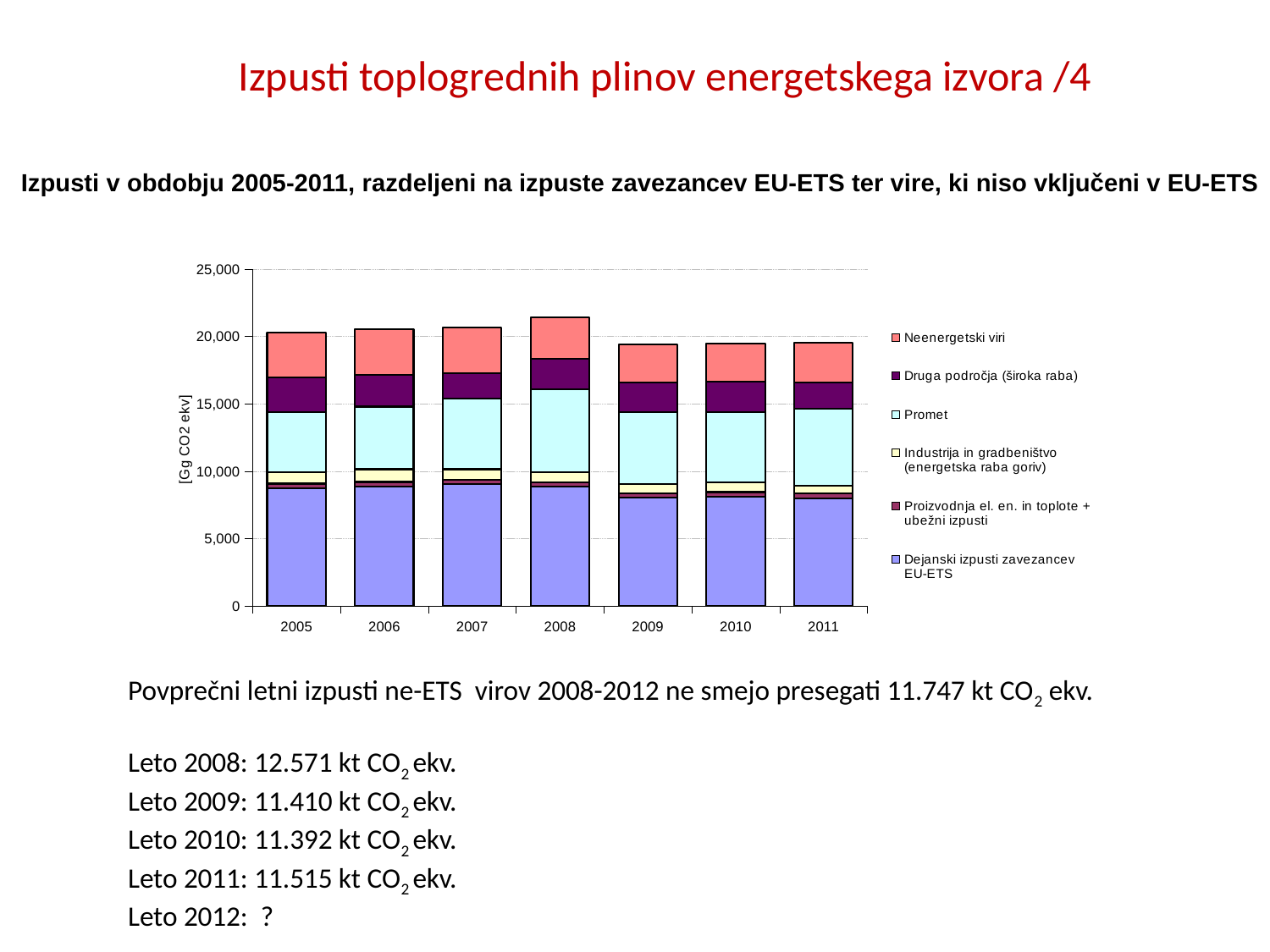
Is the total stacked bar for 2011 greater or less than 15,000? greater How many series does the chart legend list? 6 What is the label of the y axis of the chart? [Gg CO2 ekv] How many years are shown on the x axis of the chart? 7 Which year has the larger total stacked bar, 2005 or 2008? 2008 Which year has the highest total stacked bar? 2008 Is the total stacked bar for 2009 greater or less than 20,000? less Which series is shown at the top of each stacked bar according to the legend? Neenergetski viri Is the value of 'Dejanski izpusti zavezancev EU-ETS' for 2005 greater or less than 10,000? less Which year has the larger total stacked bar, 2008 or 2009? 2008 What kind of chart is shown on the slide? stacked bar chart